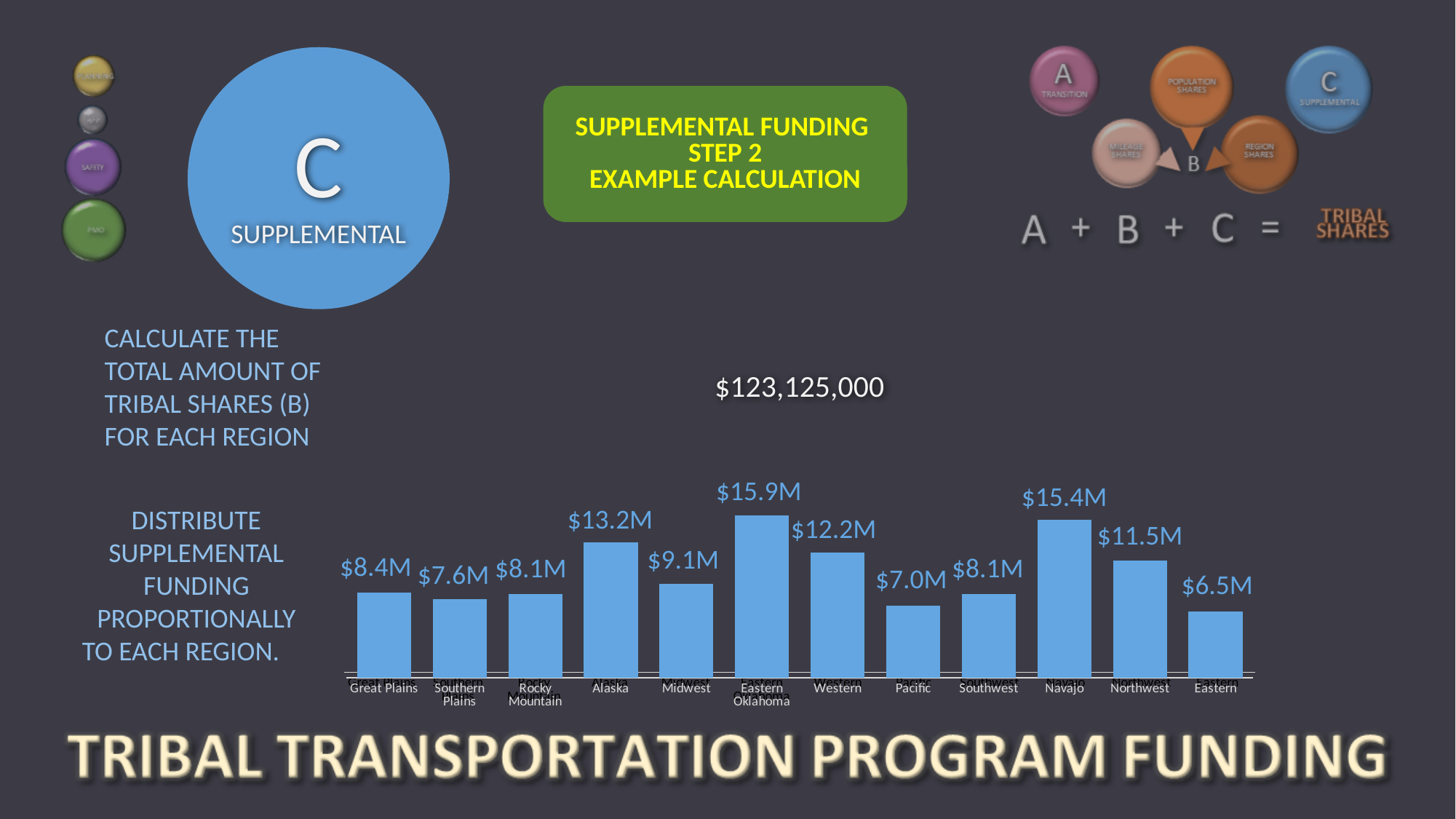
How many regions are shown in the bar chart? 12 What is the value for Alaska in the bar chart? $13.2M Which region has the lowest value in the bar chart? Eastern What is the value for Pacific in the bar chart? $7.0M What is the title shown above the bar chart? $123,125,000 What is the value for Northwest in the bar chart? $11.5M What is the difference between the values for Eastern Oklahoma and Navajo in the bar chart? $0.5M Which is larger in the bar chart, the value for Midwest or the value for Southern Plains? Midwest What is the value for Navajo in the bar chart? $15.4M What kind of chart is shown on the slide? Bar chart Which region has the highest value in the bar chart? Eastern Oklahoma What is the difference between the values for Alaska and Western in the bar chart? $1.0M